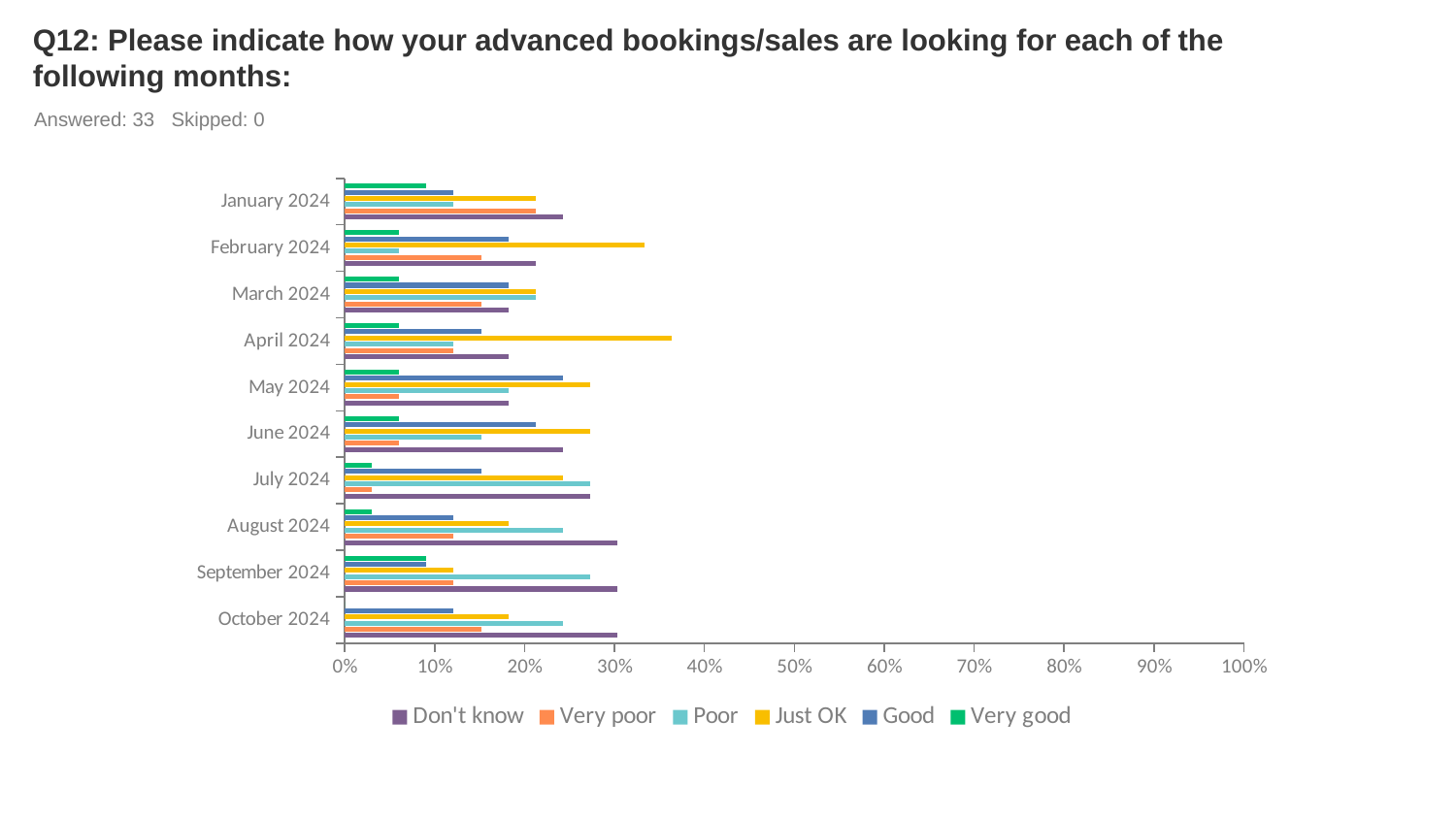
For February 2024, which is larger: the 'Just OK' value or the 'Good' value? Just OK Which series is listed first in the chart legend? Don't know Is the 'Very poor' value for July 2024 greater or less than 10%? less How many series does the legend list? 6 Which month has the highest 'Just OK' value? April 2024 Is the 'Don't know' value for January 2024 greater or less than 20%? greater Is the 'Very good' value for June 2024 greater or less than 10%? less For July 2024, which is larger: the 'Don't know' value or the 'Very poor' value? Don't know What kind of chart is shown on the slide? bar chart How many months are listed on the vertical axis of the chart? 10